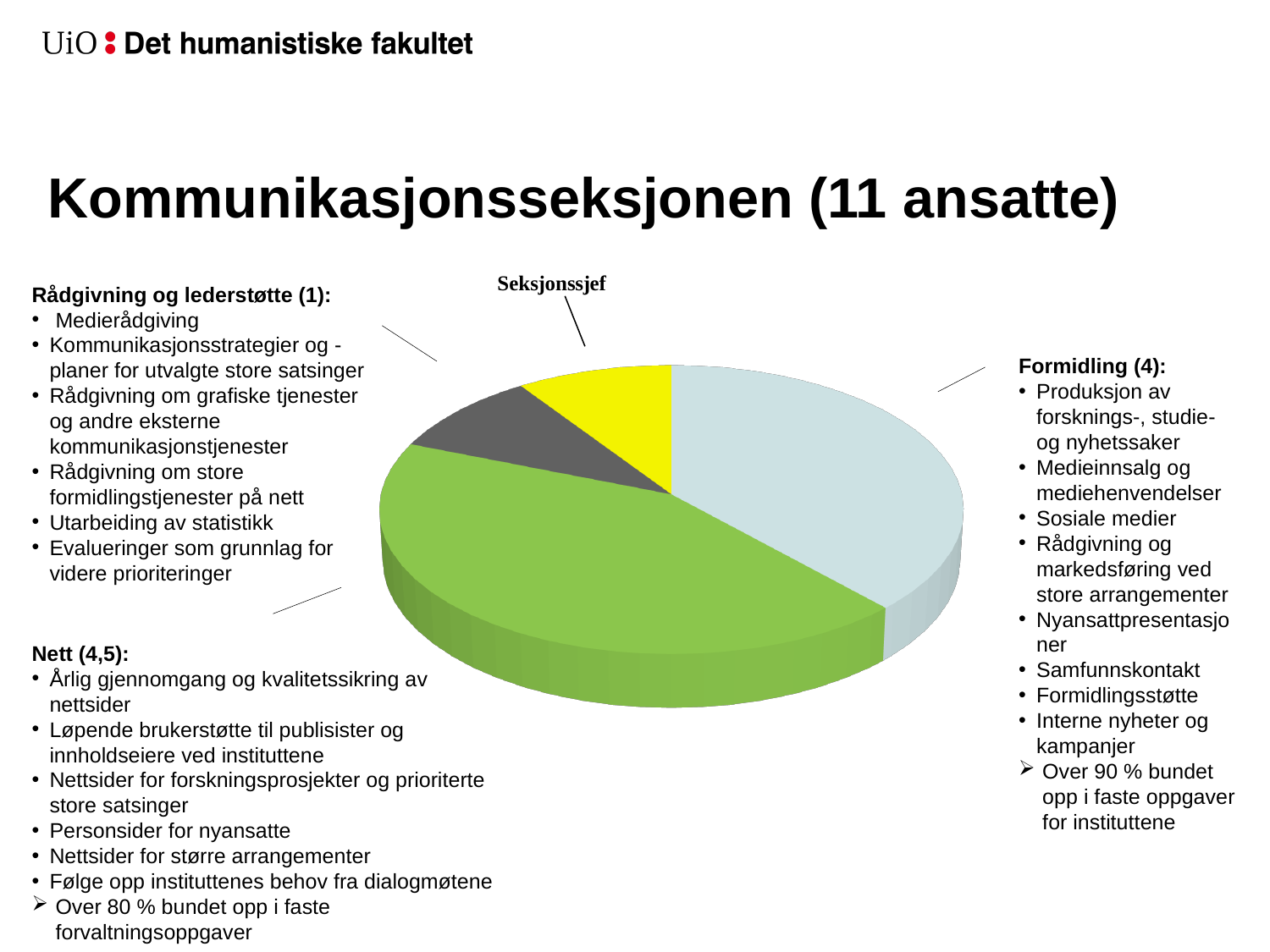
What colour is the Nett slice in the pie chart? green How many employees are in the Nett group according to the slide? 4,5 Which is larger, the Formidling slice or the Seksjonssjef slice? Formidling Which group has the largest slice of the pie chart? Nett What colour is the Seksjonssjef slice in the pie chart? yellow How many employees are in the Rådgivning og lederstøtte group according to the slide? 1 How many employees are in the Formidling group according to the slide? 4 Which is larger, the Nett group or the Formidling group? Nett What kind of chart is shown on the slide? pie chart How many employees does the slide title say the Kommunikasjonsseksjonen has in total? 11 What is the difference between the Nett group (4,5) and the Formidling group (4)? 0,5 How many slices does the pie chart have? 4